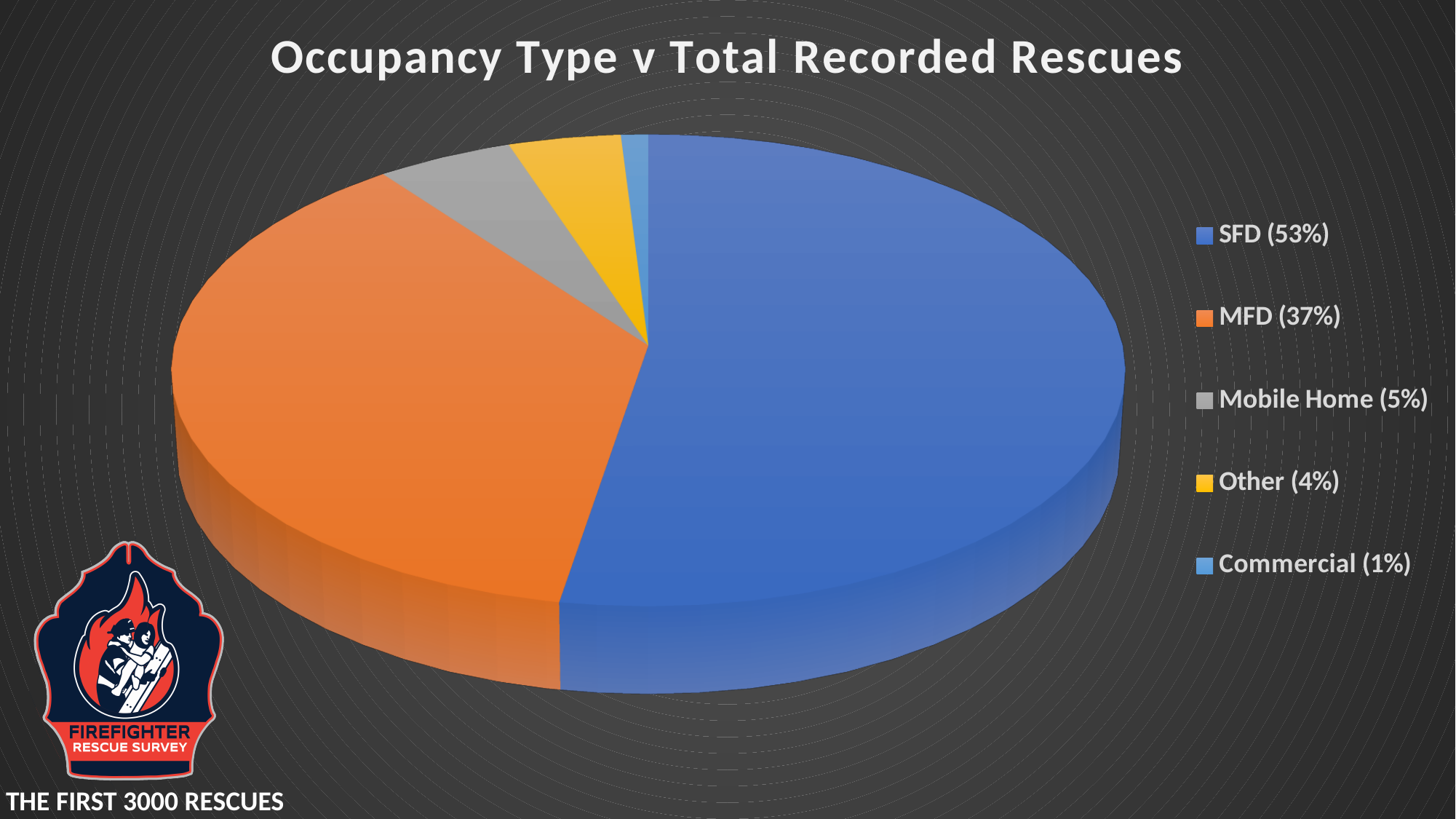
What colour is the MFD slice? Orange Which has a larger share, Mobile Home or Other? Mobile Home What share of total recorded rescues is Commercial? 1% What is the difference in percentage points between SFD and MFD? 16 What share of total recorded rescues is SFD? 53% What share of total recorded rescues is MFD? 37% Which occupancy type has the largest share of rescues? SFD How many occupancy types are shown in the pie chart? 5 What type of chart is shown on the slide? Pie chart Which occupancy type has the smallest share of rescues? Commercial What is the title of the chart? Occupancy Type v Total Recorded Rescues